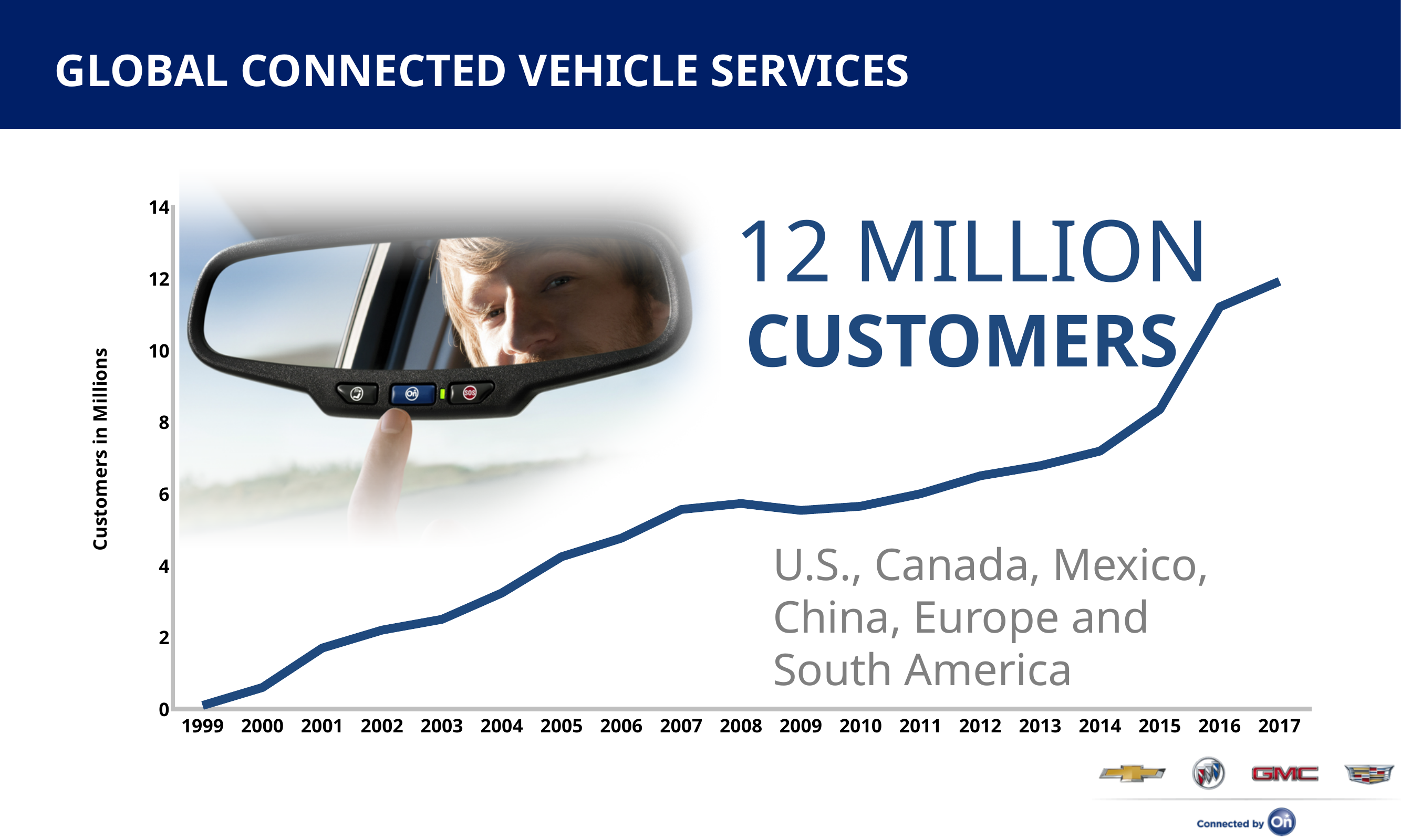
Which year has the highest value in the chart? 2017 What is the label of the y axis of the chart? Customers in Millions Do the values in the chart generally rise or fall from 1999 to 2017? rise Is the value for 2017 greater or less than 10? greater Which year has the lowest value in the chart? 1999 How many years are plotted along the x axis of the chart? 19 Is the value for 2005 greater or less than 2? greater Is the value for 2009 greater or less than 6? less What kind of chart is shown on the slide? line chart Which year has the larger value, 2008 or 2016? 2016